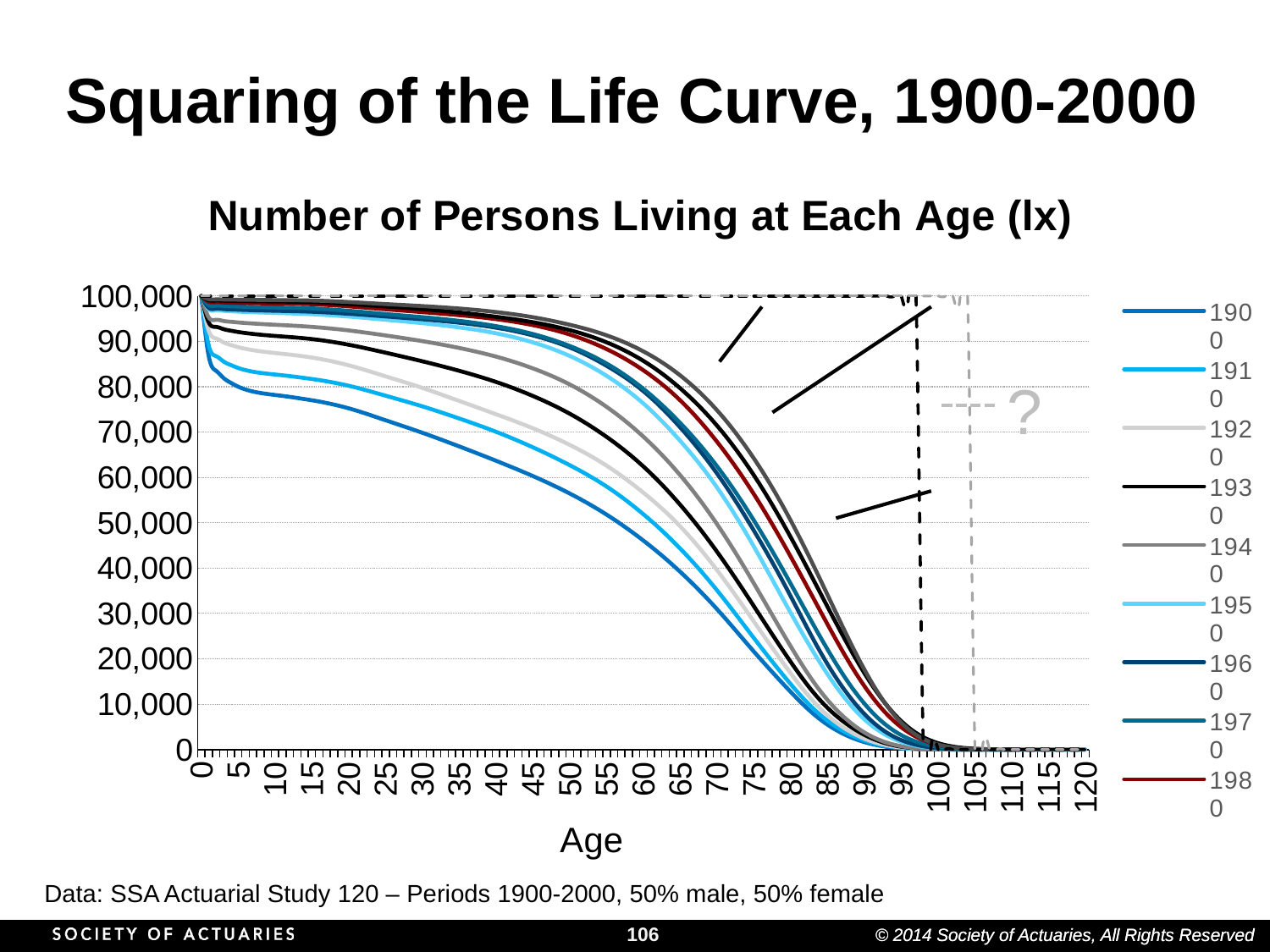
At age 40, which series has the larger value, 1900 or 1980? 1980 Do the values of the 1900 series rise or fall as age increases along the x axis? Fall Which series has the lowest value at age 10? 1900 What is the label of the x axis? Age What kind of chart is shown on the slide? Line chart Is the value for the 1900 series at age 5 greater or less than 90,000? less What is the highest value shown on the y axis? 100,000 Which series has the lowest value at age 50? 1900 Is the value for the 1900 series at age 20 greater or less than 70,000? greater What is the title of the chart? Number of Persons Living at Each Age (lx) What is the largest age shown on the x axis? 120